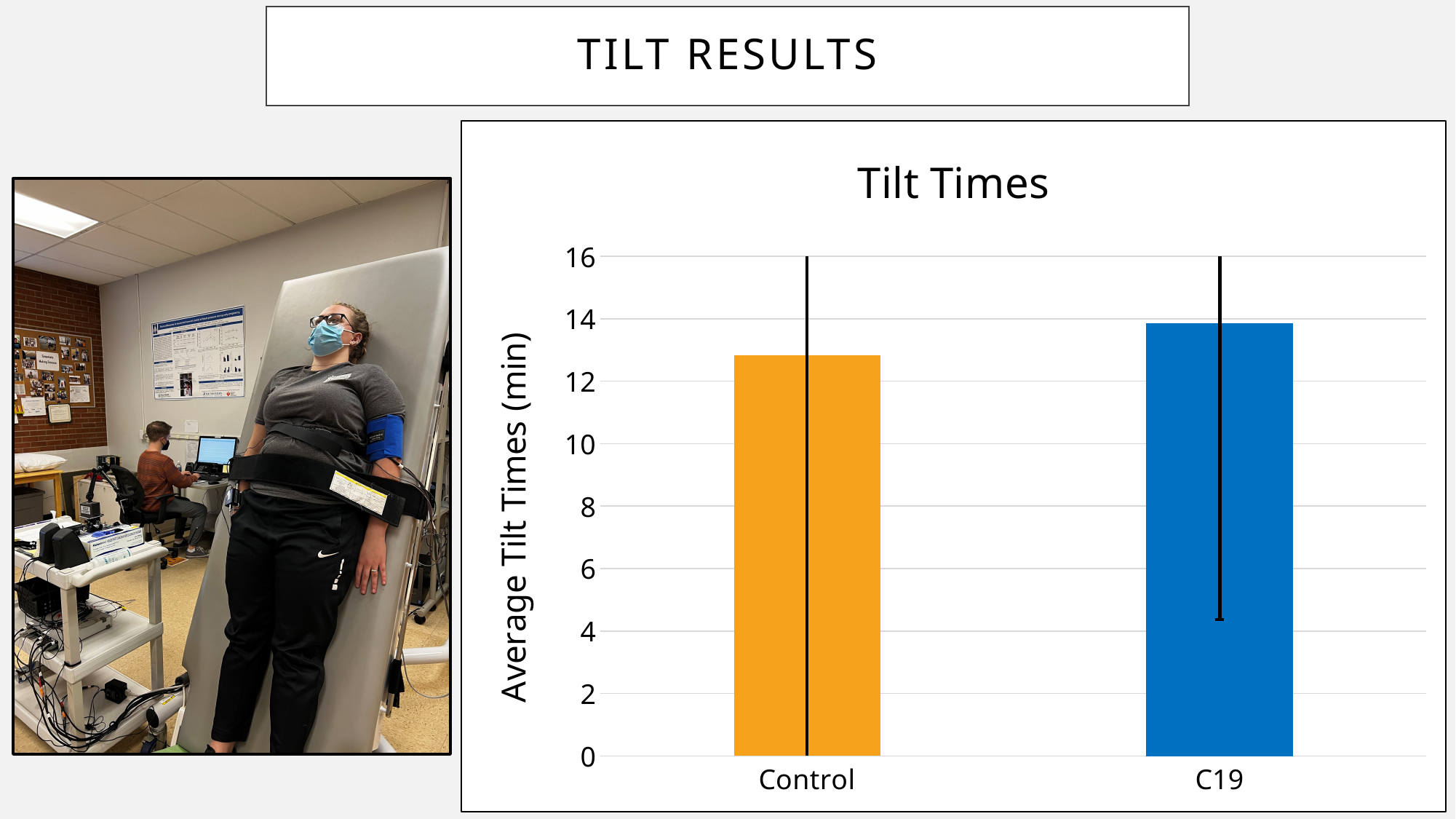
Which category has the lowest average tilt time? Control Which has a larger average tilt time, Control or C19? C19 Is the value for Control greater or less than 14? less What is the title of the chart? Tilt Times Is the value for C19 greater or less than 12? greater Which category has the highest average tilt time? C19 What is the label of the vertical axis? Average Tilt Times (min) What kind of chart is shown on the slide? bar chart Is the value for C19 greater or less than 16? less How many categories are plotted in the Tilt Times chart? 2